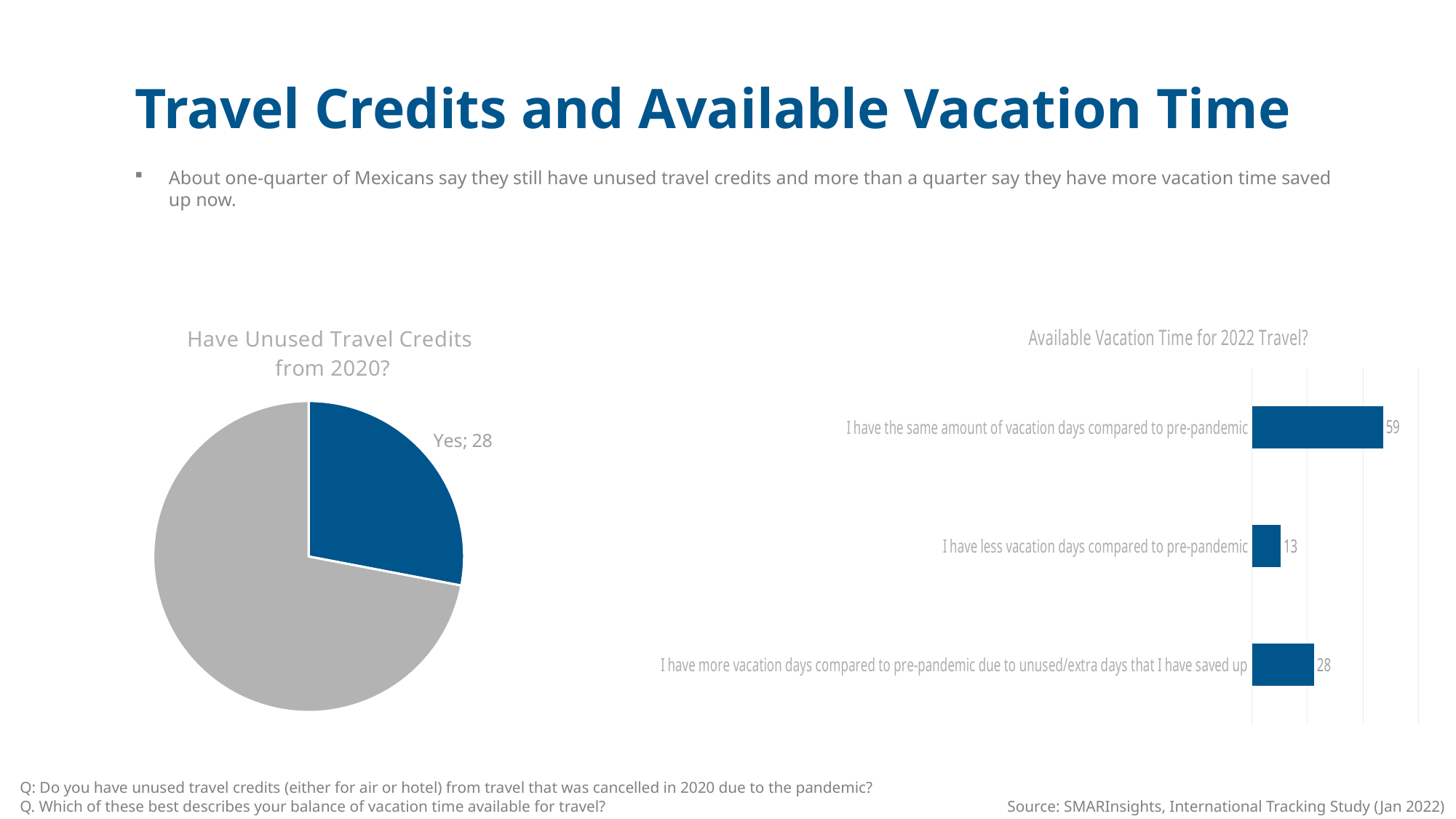
In the 'Available Vacation Time for 2022 Travel?' chart, which category has the lowest value? I have less vacation days compared to pre-pandemic What kind of chart is the 'Available Vacation Time for 2022 Travel?' chart? bar chart In the 'Available Vacation Time for 2022 Travel?' chart, which category has the highest value? I have the same amount of vacation days compared to pre-pandemic In the 'Available Vacation Time for 2022 Travel?' chart, what is the value for 'I have the same amount of vacation days compared to pre-pandemic'? 59 How many categories are shown in the 'Available Vacation Time for 2022 Travel?' chart? 3 In the 'Have Unused Travel Credits from 2020?' chart, which slice is larger, the blue 'Yes' slice or the grey slice? the grey slice What kind of chart is the 'Have Unused Travel Credits from 2020?' chart? pie chart In the 'Available Vacation Time for 2022 Travel?' chart, what is the value for 'I have less vacation days compared to pre-pandemic'? 13 In the 'Have Unused Travel Credits from 2020?' chart, how many slices does the pie have? 2 In the 'Have Unused Travel Credits from 2020?' chart, what value is shown for the 'Yes' slice? 28 In the 'Available Vacation Time for 2022 Travel?' chart, what is the difference between the value for 'I have the same amount of vacation days compared to pre-pandemic' and the value for 'I have less vacation days compared to pre-pandemic'? 46 In the 'Available Vacation Time for 2022 Travel?' chart, what is the value for 'I have more vacation days compared to pre-pandemic due to unused/extra days that I have saved up'? 28